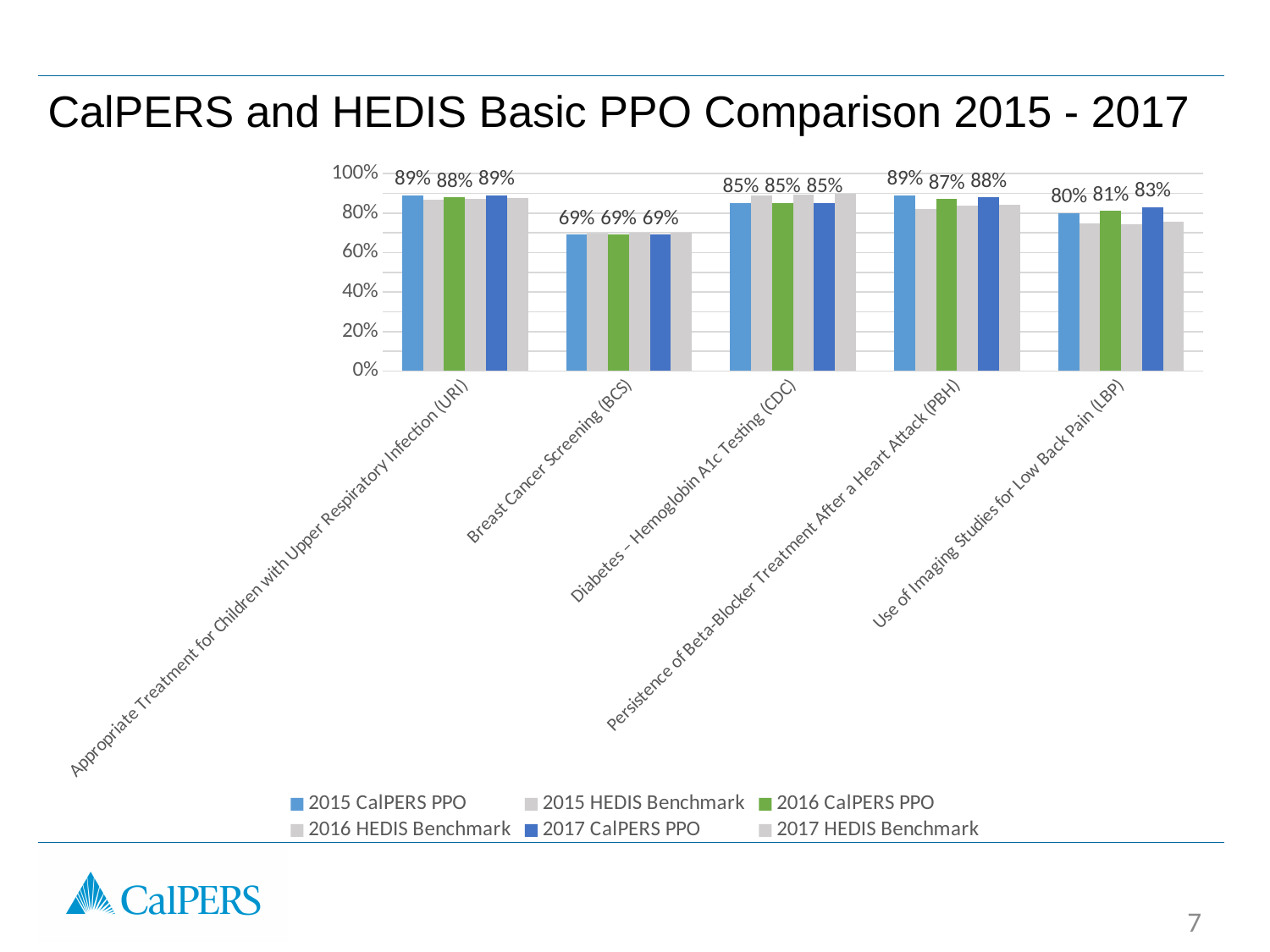
What is the 2017 CalPERS PPO value for Use of Imaging Studies for Low Back Pain (LBP)? 83% What is the 2015 CalPERS PPO value for Diabetes – Hemoglobin A1c Testing (CDC)? 85% What is the 2016 CalPERS PPO value for Persistence of Beta-Blocker Treatment After a Heart Attack (PBH)? 87% How many measure categories are shown along the x axis? 5 Which category has the lowest 2015 CalPERS PPO value? Breast Cancer Screening (BCS) How many series does the legend list? 6 What is the 2015 CalPERS PPO value for Breast Cancer Screening (BCS)? 69% Which is larger for Persistence of Beta-Blocker Treatment After a Heart Attack (PBH): the 2015 CalPERS PPO value or the 2016 CalPERS PPO value? 2015 CalPERS PPO What is the title of the chart? CalPERS and HEDIS Basic PPO Comparison 2015 - 2017 What type of chart is shown on the slide? bar chart Is the 2015 HEDIS Benchmark value for Breast Cancer Screening (BCS) greater or less than 80%? less What is the difference between the 2017 CalPERS PPO and 2015 CalPERS PPO values for Use of Imaging Studies for Low Back Pain (LBP)? 3%